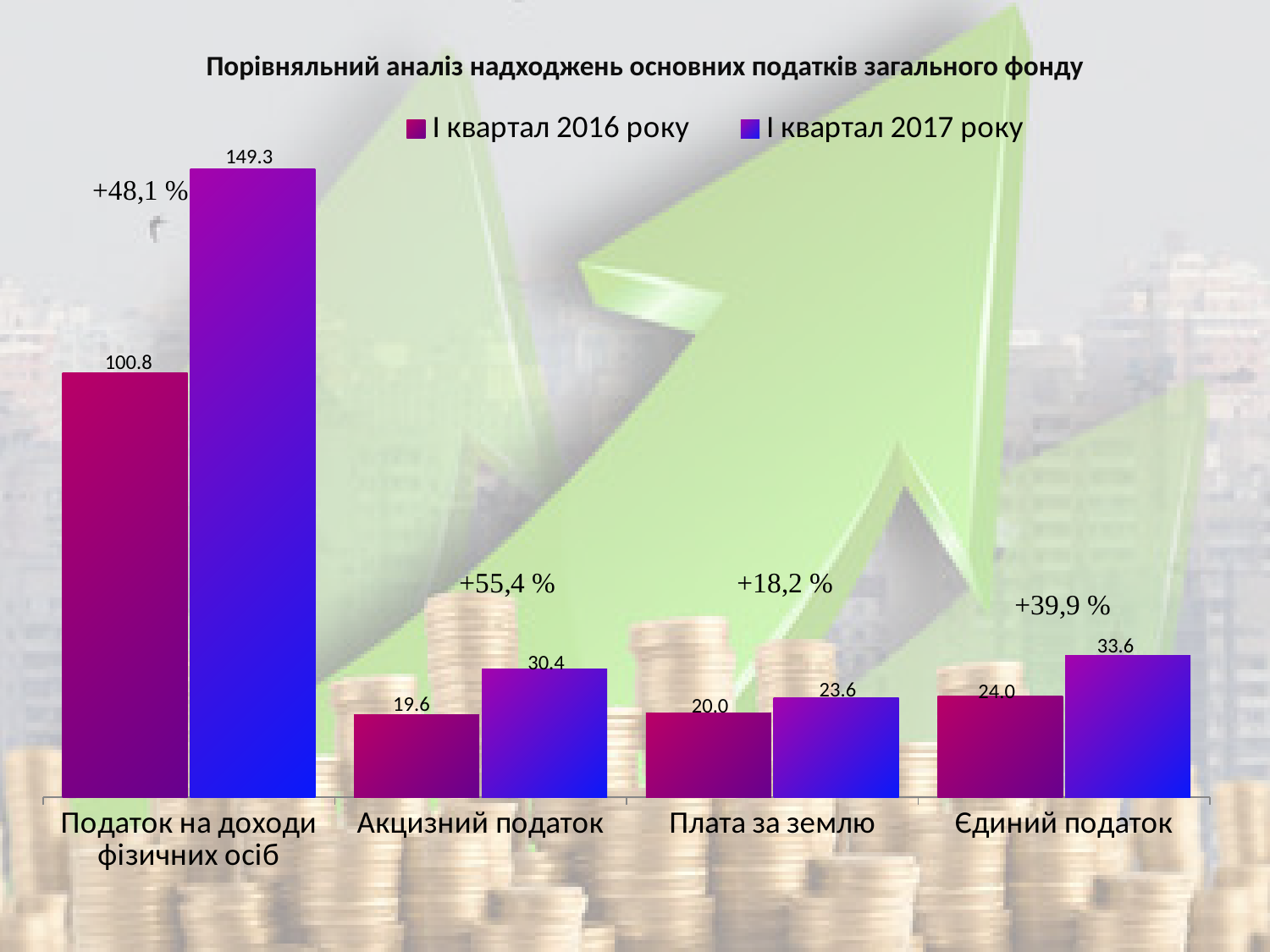
How many series does the legend list? 2 Which is larger for Єдиний податок: the І квартал 2016 року value or the І квартал 2017 року value? І квартал 2017 року Which category has the highest value in І квартал 2017 року? Податок на доходи фізичних осіб What is the value for Плата за землю in І квартал 2017 року? 23.6 What kind of chart is shown on the slide? Bar chart What is the value for Податок на доходи фізичних осіб in І квартал 2017 року? 149.3 What is the value for Єдиний податок in І квартал 2016 року? 24.0 How many categories are shown on the x axis? 4 What is the value for Акцизний податок in І квартал 2016 року? 19.6 What percentage change is annotated above the bars for Акцизний податок? +55,4 % Which category has the lowest value in І квартал 2016 року? Акцизний податок What is the difference between the І квартал 2017 року and І квартал 2016 року values for Податок на доходи фізичних осіб? 48.5